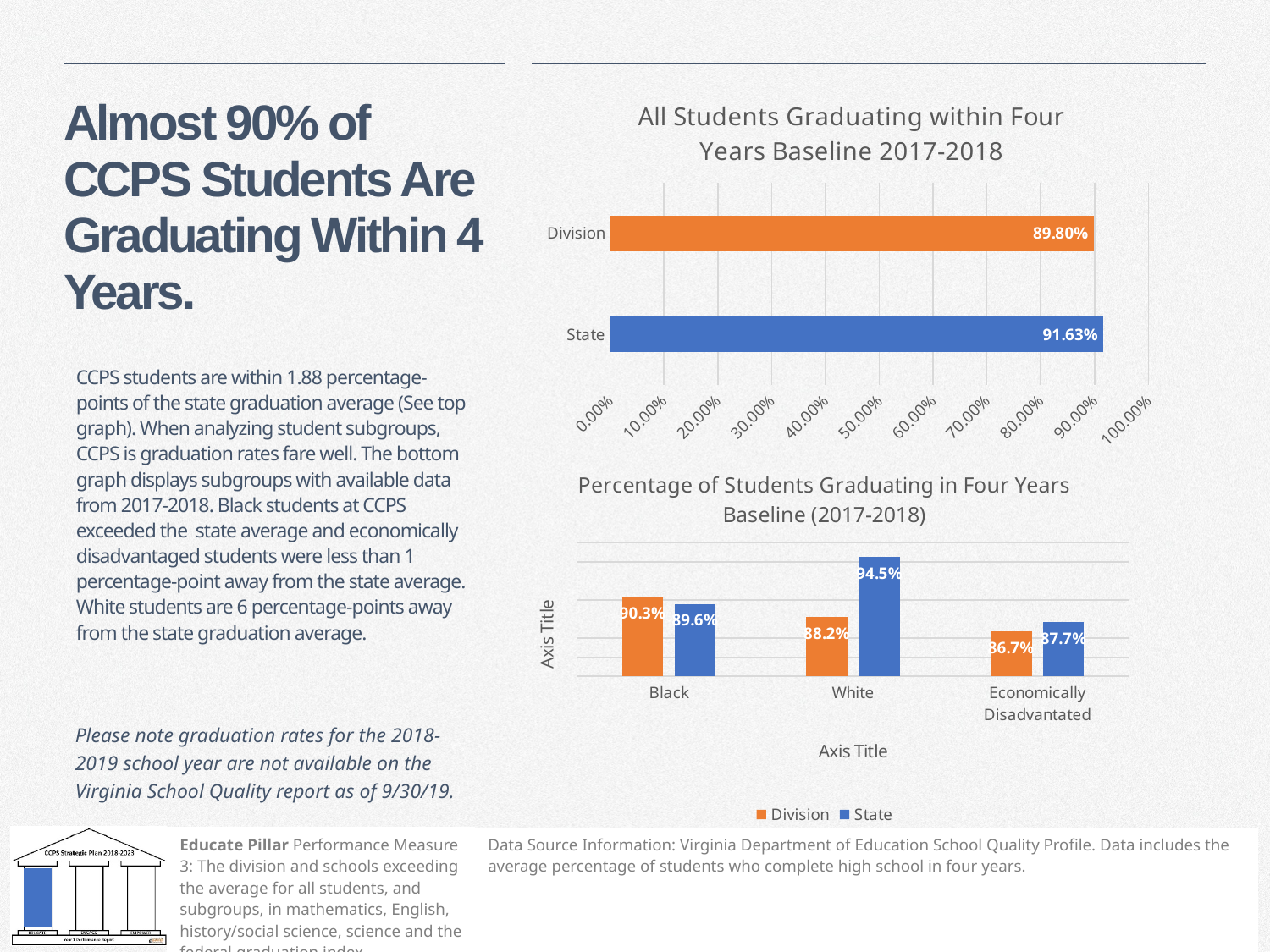
In the bottom chart, 'Percentage of Students Graduating in Four Years Baseline (2017-2018)', which category has the lowest Division value? Economically Disadvantaged In the bottom chart, 'Percentage of Students Graduating in Four Years Baseline (2017-2018)', what is the difference between the State and Division values for White students? 6.3% In the top chart, 'All Students Graduating within Four Years Baseline 2017-2018', what is the difference between the State and Division values? 1.83% In the top chart, 'All Students Graduating within Four Years Baseline 2017-2018', which category has the higher value, Division or State? State In the top chart, 'All Students Graduating within Four Years Baseline 2017-2018', what is the value for Division? 89.80% In the bottom chart, 'Percentage of Students Graduating in Four Years Baseline (2017-2018)', what is the Division value for White students? 88.2% In the bottom chart, 'Percentage of Students Graduating in Four Years Baseline (2017-2018)', what is the State value for Economically Disadvantaged students? 87.7% What kind of chart is the top chart, 'All Students Graduating within Four Years Baseline 2017-2018'? Bar chart In the bottom chart, 'Percentage of Students Graduating in Four Years Baseline (2017-2018)', which category has the highest State value? White In the top chart, 'All Students Graduating within Four Years Baseline 2017-2018', what is the value for State? 91.63% How many series does the legend of the bottom chart, 'Percentage of Students Graduating in Four Years Baseline (2017-2018)', list? 2 How many categories are shown on the x axis of the bottom chart, 'Percentage of Students Graduating in Four Years Baseline (2017-2018)'? 3